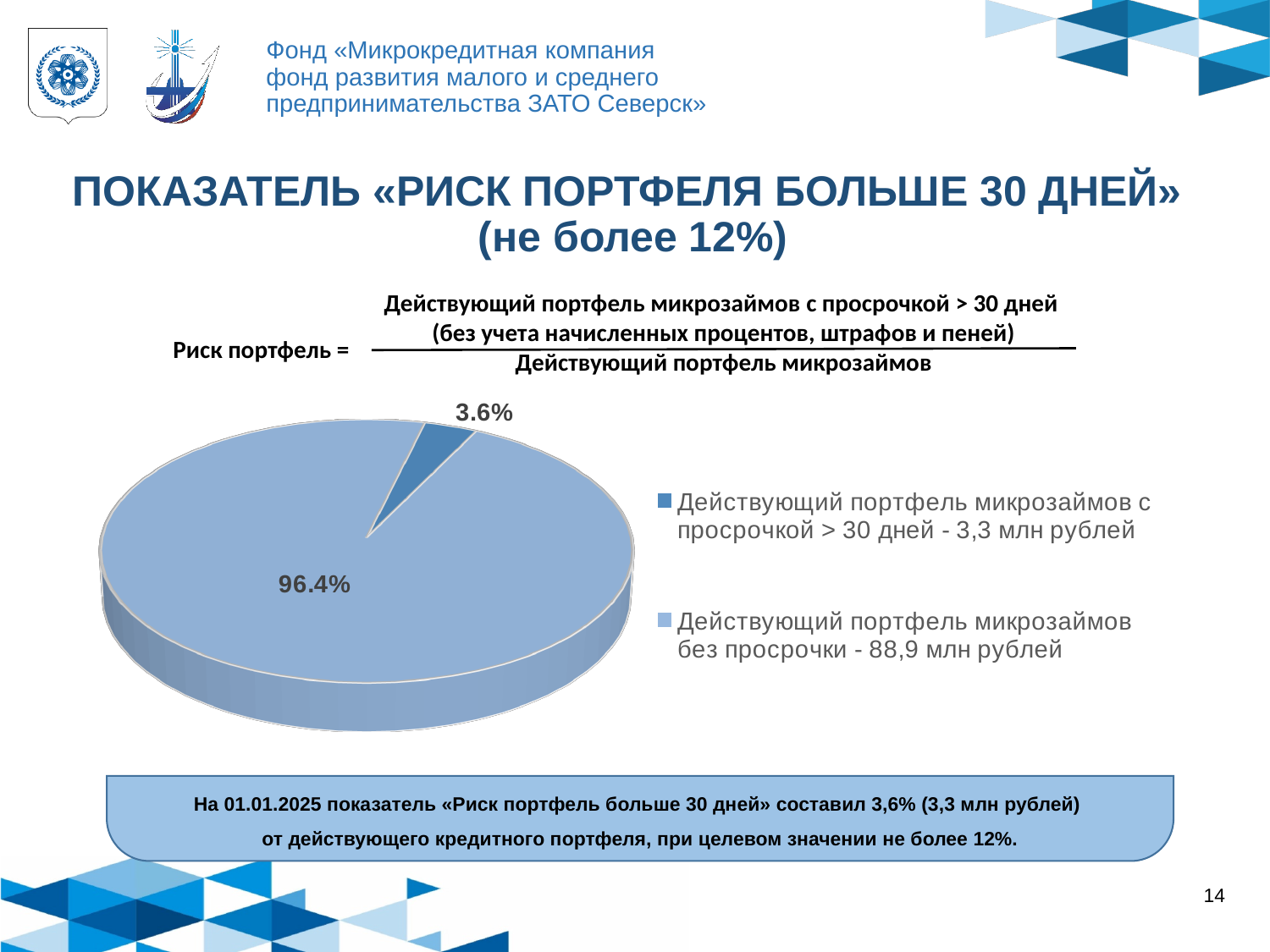
Which slice of the pie chart is the smallest? Действующий портфель микрозаймов с просрочкой > 30 дней What kind of chart is shown on the slide? Pie chart According to the legend, what is the value in million rubles of the microloan portfolio with overdue > 30 days? 3,3 млн рублей Which is larger: the share of the portfolio with overdue > 30 days or the share without overdue? Without overdue (без просрочки) How many slices does the pie chart have? 2 What is the difference in percentage points between the two slices of the pie chart? 92.8 What share of the pie is labelled for the microloan portfolio with overdue > 30 days (Действующий портфель микрозаймов с просрочкой > 30 дней)? 3.6% How many entries does the legend of the pie chart list? 2 According to the legend, what is the value in million rubles of the microloan portfolio without overdue? 88,9 млн рублей Which slice of the pie chart is the largest? Действующий портфель микрозаймов без просрочки What is the target threshold for the 'Риск портфеля больше 30 дней' indicator stated in the slide title? не более 12% What share of the pie is labelled for the microloan portfolio without overdue (Действующий портфель микрозаймов без просрочки)? 96.4%